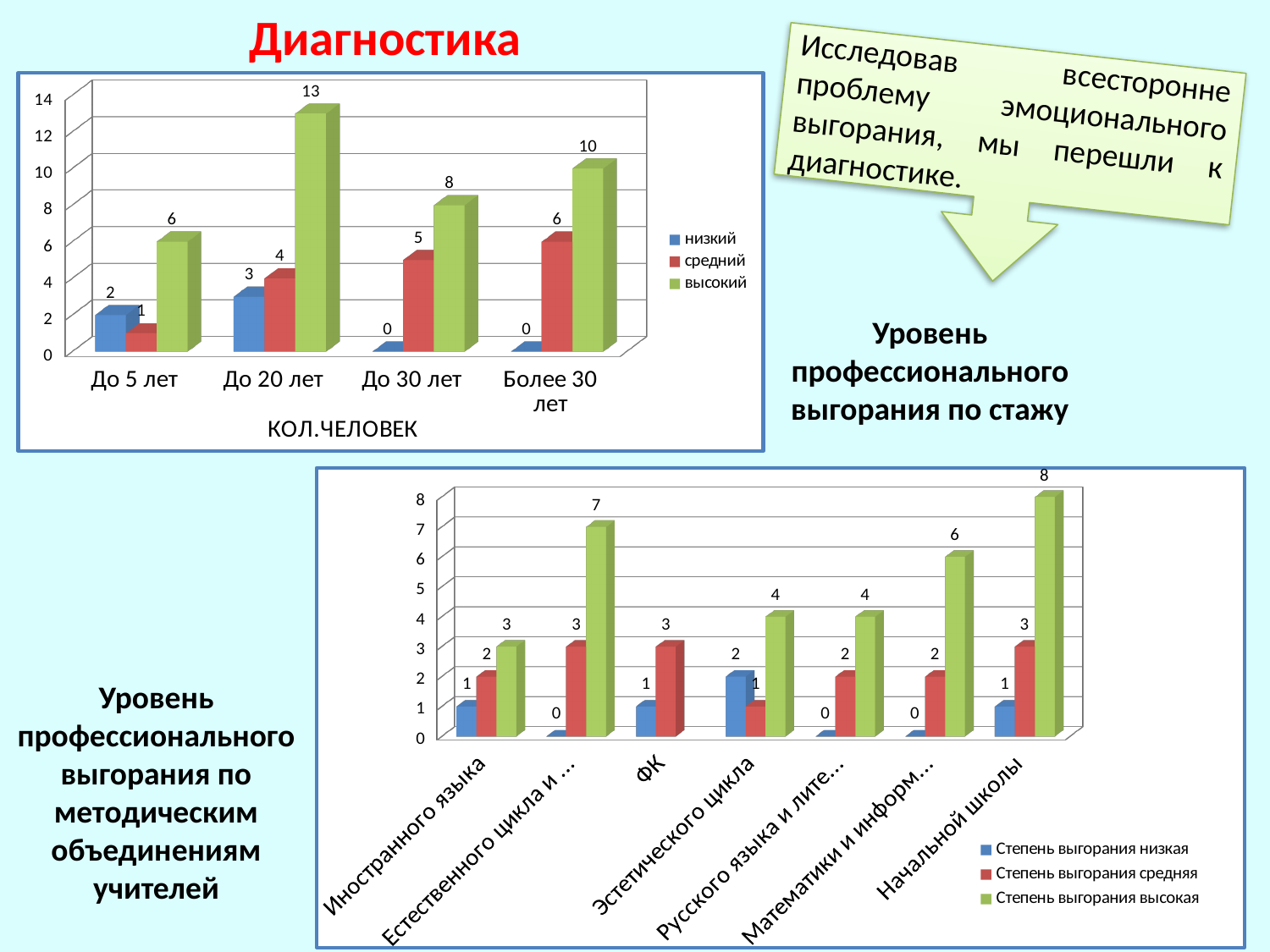
In the bottom chart, how many categories are shown on the x axis? 7 In the bottom chart, what is the value of Степень выгорания низкая for Эстетического цикла? 2 In the top chart, how many series does the legend list? 3 In the bottom chart, which category has the lowest value for Степень выгорания высокая among those with a green bar shown? Иностранного языка In the bottom chart, which is larger: Степень выгорания высокая for Математики и информ... or for Русского языка и лите...? Математики и информ... In the top chart, what is the x-axis title? КОЛ.ЧЕЛОВЕК What type of chart is the bottom chart? bar chart In the top chart (Уровень профессионального выгорания по стажу), what is the value of the высокий series for До 20 лет? 13 In the top chart, which category has the highest value for the высокий series? До 20 лет In the top chart, what is the difference between the высокий and средний values for До 30 лет? 3 In the top chart, what is the value of the средний series for Более 30 лет? 6 In the bottom chart (Уровень профессионального выгорания по методическим объединениям учителей), what is the value of Степень выгорания высокая for Начальной школы? 8